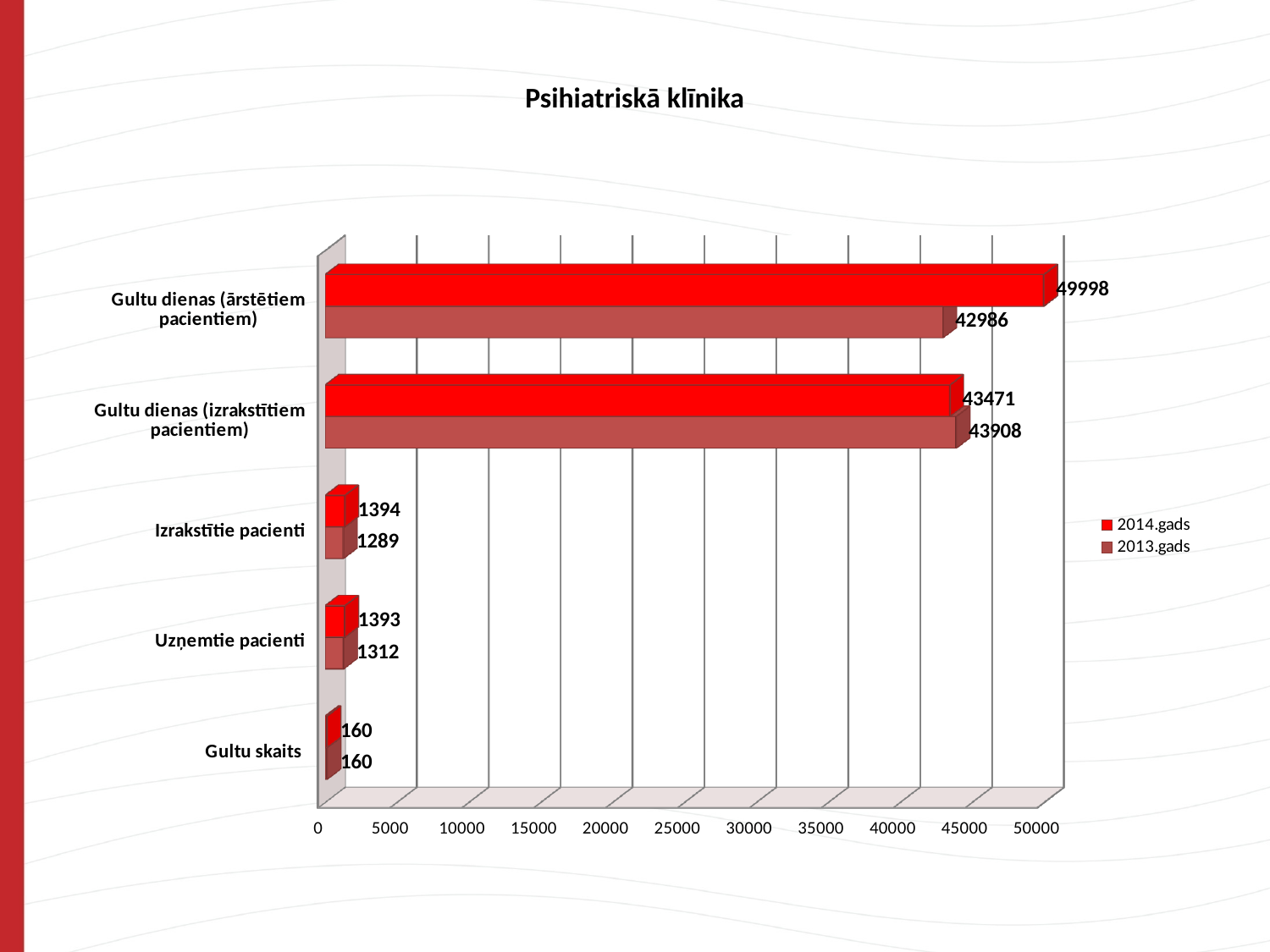
What is the difference between the 2014.gads and 2013.gads values for Gultu dienas (ārstētiem pacientiem)? 7012 What is the value for Uzņemtie pacienti in 2014.gads? 1393 How many series does the legend list? 2 How many categories are shown on the chart? 5 Which is larger for Gultu dienas (izrakstītiem pacientiem): the 2014.gads value or the 2013.gads value? 2013.gads What is the value for Izrakstītie pacienti in 2013.gads? 1289 Which category has the lowest value in the 2013.gads series? Gultu skaits What kind of chart is shown on the slide? Bar chart What is the title of the chart? Psihiatriskā klīnika What is the value for Gultu dienas (izrakstītiem pacientiem) in 2013.gads? 43908 What is the value for Gultu dienas (ārstētiem pacientiem) in 2014.gads? 49998 Which category has the highest value in the 2014.gads series? Gultu dienas (ārstētiem pacientiem)